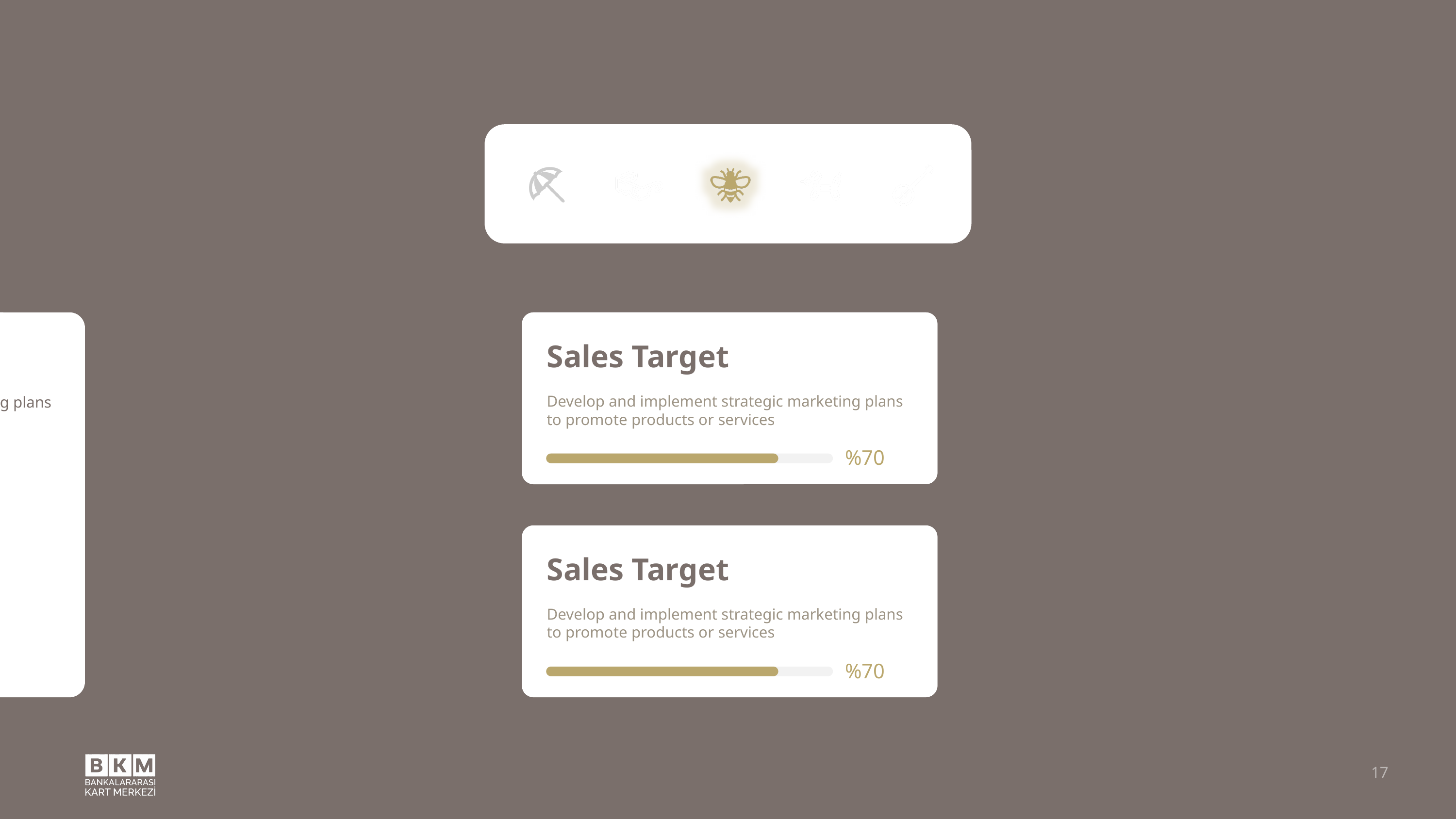
What is the title of the card containing the upper progress bar? Sales Target Is the value shown for the upper Sales Target progress bar greater or less than 50? greater How many progress bars are shown on the slide? 2 What value is shown next to the progress bar in the lower Sales Target card? %70 What colour is the filled portion of the progress bars? Gold What is the difference between the values of the upper and lower Sales Target progress bars? 0 Is the value shown for the lower Sales Target progress bar greater or less than 100? less What value is shown next to the progress bar in the upper Sales Target card? %70